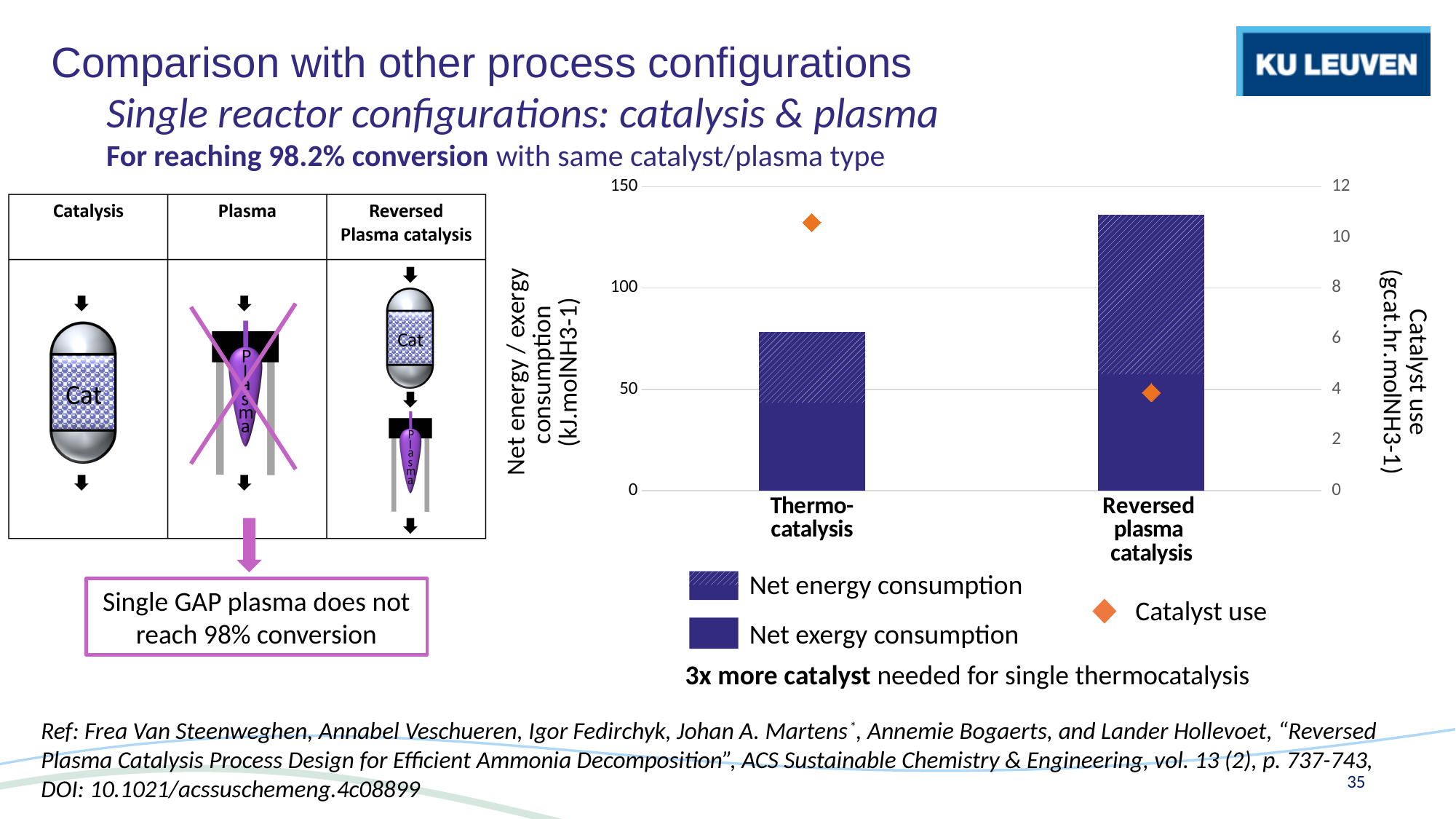
What is the label of the right-hand vertical axis? Catalyst use (gcat.hr.molNH3-1) Is the total stacked bar for Thermo-catalysis greater or less than 100 kJ.molNH3-1? less Which category has the taller stacked bar, Thermo-catalysis or Reversed plasma catalysis? Reversed plasma catalysis Is the Catalyst use value for Reversed plasma catalysis greater or less than 6 gcat.hr.molNH3-1? less How many categories are shown on the x axis of the chart? 2 Is the Catalyst use value for Thermo-catalysis greater or less than 8 gcat.hr.molNH3-1? greater Which category has the higher Catalyst use marker? Thermo-catalysis Which series is shown with a hatched fill in the legend? Net energy consumption Which category has the lower Catalyst use marker? Reversed plasma catalysis What kind of chart is shown on the slide? stacked bar chart with markers How many series does the chart legend list? 3